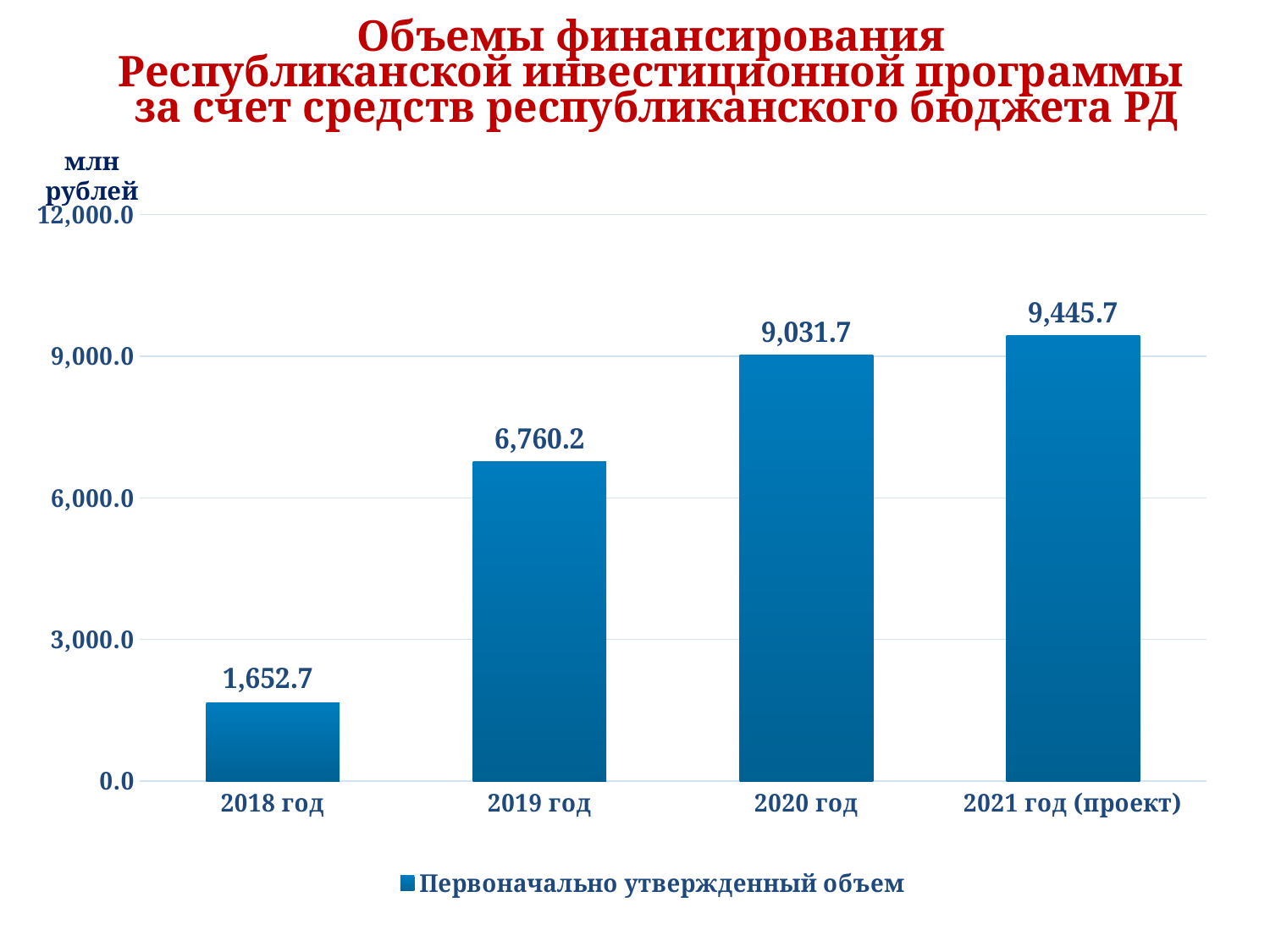
Which year has the lowest value? 2018 год What is the difference between the values for 2021 год (проект) and 2020 год? 414.0 What is the value for 2021 год (проект)? 9,445.7 What is the value for 2020 год? 9,031.7 What is the difference between the values for 2019 год and 2018 год? 5,107.5 Which is larger, the value for 2019 год or the value for 2020 год? 2020 год How many years are shown on the chart? 4 What is the value for 2018 год? 1,652.7 Which year has the highest value? 2021 год (проект) What is the value for 2019 год? 6,760.2 Do the values rise or fall from 2018 год to 2021 год (проект)? rise What kind of chart is shown on the slide? bar chart